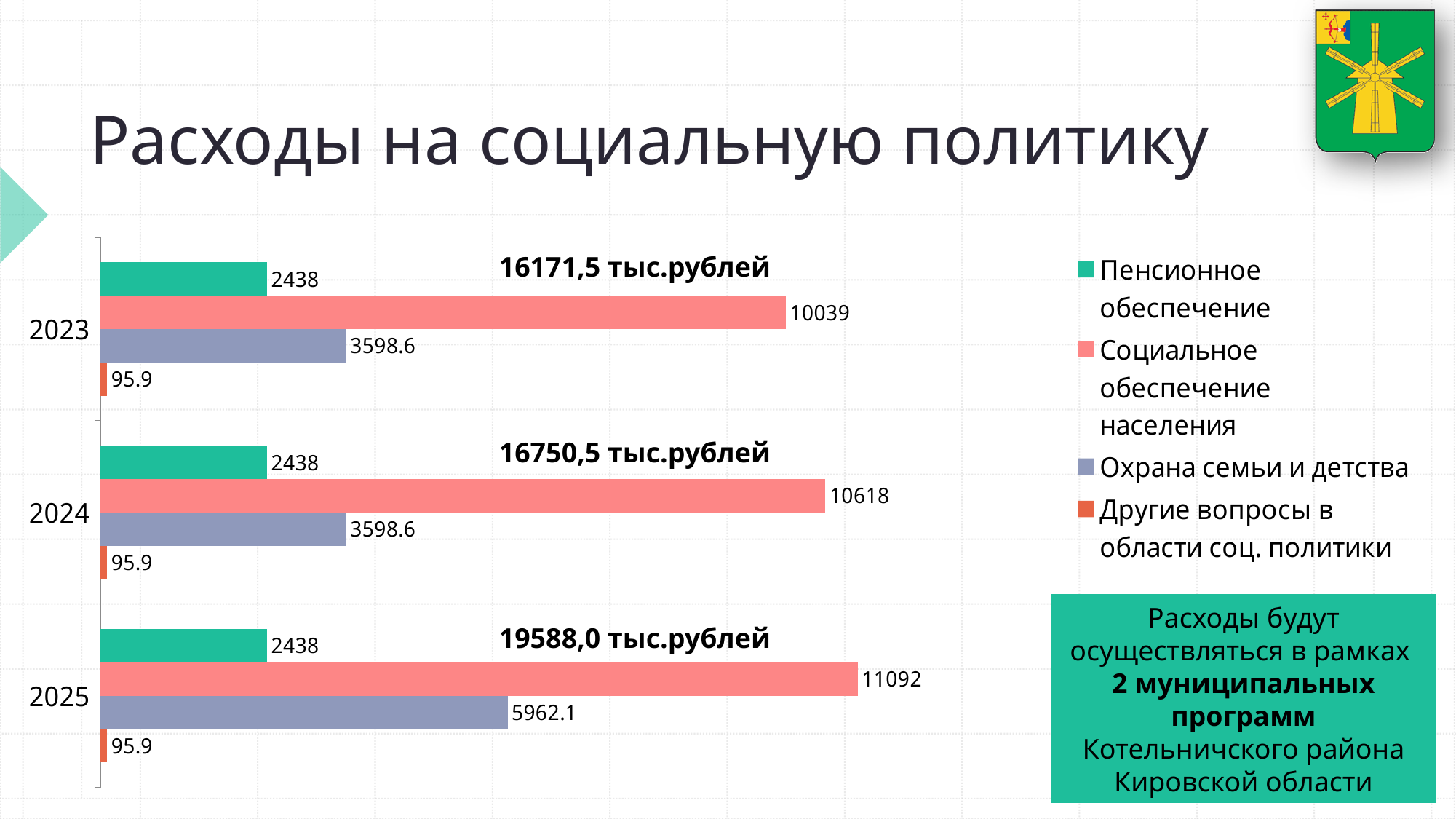
Which series has the lowest value in 2024? Другие вопросы в области соц. политики What is the value for Социальное обеспечение населения in 2024? 10618 How many series does the legend list? 4 In which year is the value for Социальное обеспечение населения the highest? 2025 What total is printed for 2025 on the chart? 19588,0 тыс.рублей What is the value for Другие вопросы в области соц. политики in 2025? 95.9 What is the value for Охрана семьи и детства in 2025? 5962.1 Which is larger in 2025: Пенсионное обеспечение or Охрана семьи и детства? Охрана семьи и детства What kind of chart is shown on the slide? Bar chart How many years are shown on the chart? 3 What is the value for Пенсионное обеспечение in 2023? 2438 What is the difference between the Социальное обеспечение населения values for 2025 and 2023? 1053